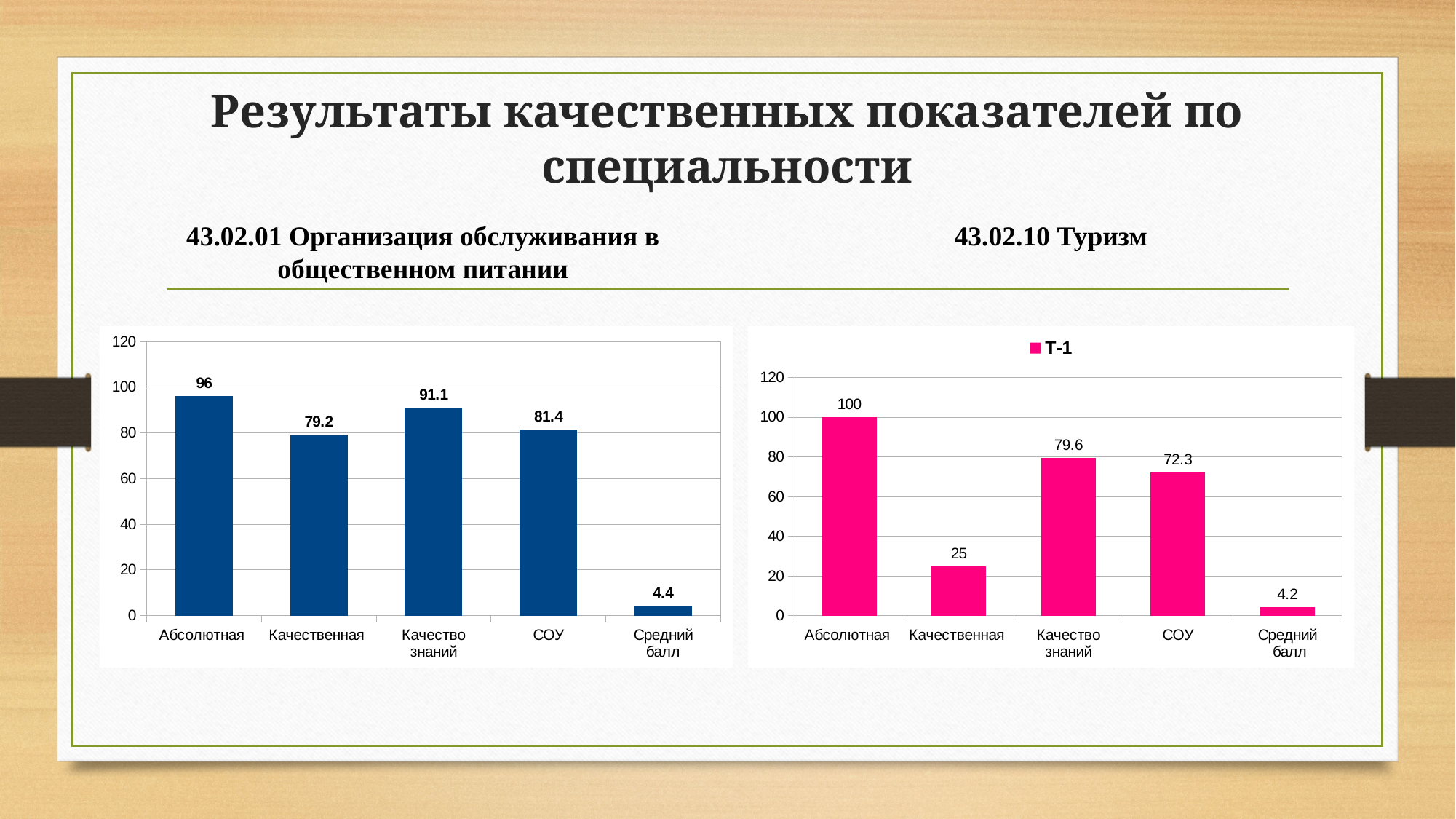
What series name does the legend of the right chart (43.02.10 Туризм) show? Т-1 What kind of chart is the left chart (43.02.01 Организация обслуживания в общественном питании)? Bar chart How many categories are shown on the x axis of the right chart (43.02.10 Туризм)? 5 In the left chart (43.02.01 Организация обслуживания в общественном питании), what is the value for Абсолютная? 96 In the left chart (43.02.01 Организация обслуживания в общественном питании), which category has the lowest value? Средний балл In the right chart (43.02.10 Туризм), which category has the highest value? Абсолютная In the right chart (43.02.10 Туризм), what is the value for СОУ? 72.3 In the left chart (43.02.01 Организация обслуживания в общественном питании), what is the value for Качество знаний? 91.1 In the right chart (43.02.10 Туризм), what is the value for Качественная? 25 In the left chart (43.02.01 Организация обслуживания в общественном питании), which is larger: the value for Качество знаний or the value for СОУ? Качество знаний In the right chart (43.02.10 Туризм), what is the difference between the values for Качество знаний and СОУ? 7.3 In the left chart (43.02.01 Организация обслуживания в общественном питании), what is the difference between the values for Абсолютная and Качественная? 16.8